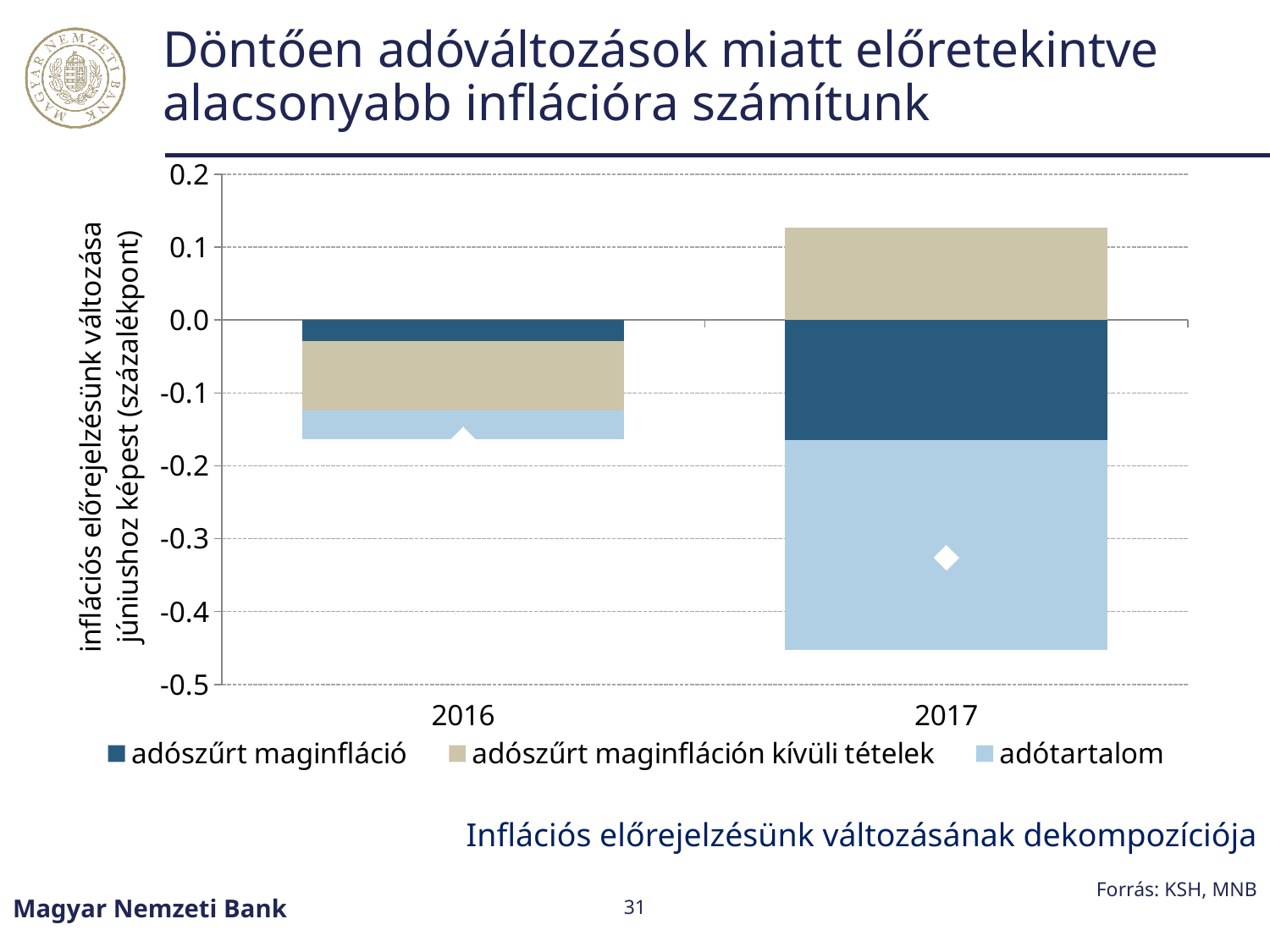
Which year has a positive (above zero) segment in its bar? 2017 Is the diamond marker for 2017 greater or less than -0.3? less Is the top of the positive segment of the 2017 bar greater or less than 0.1? greater What kind of chart is shown on the slide? stacked bar chart Does the diamond marker (total change) rise or fall from 2016 to 2017? fall How many series does the legend list? 3 Is the lowest point of the 2017 bar greater or less than -0.4? less Which series is shown in the lightest blue colour in the legend? adótartalom Which series contributes the positive segment in 2017? adószűrt maginfláción kívüli tételek What is the title of the chart shown below the plot? Inflációs előrejelzésünk változásának dekompozíciója How many years (categories) are shown on the x axis? 2